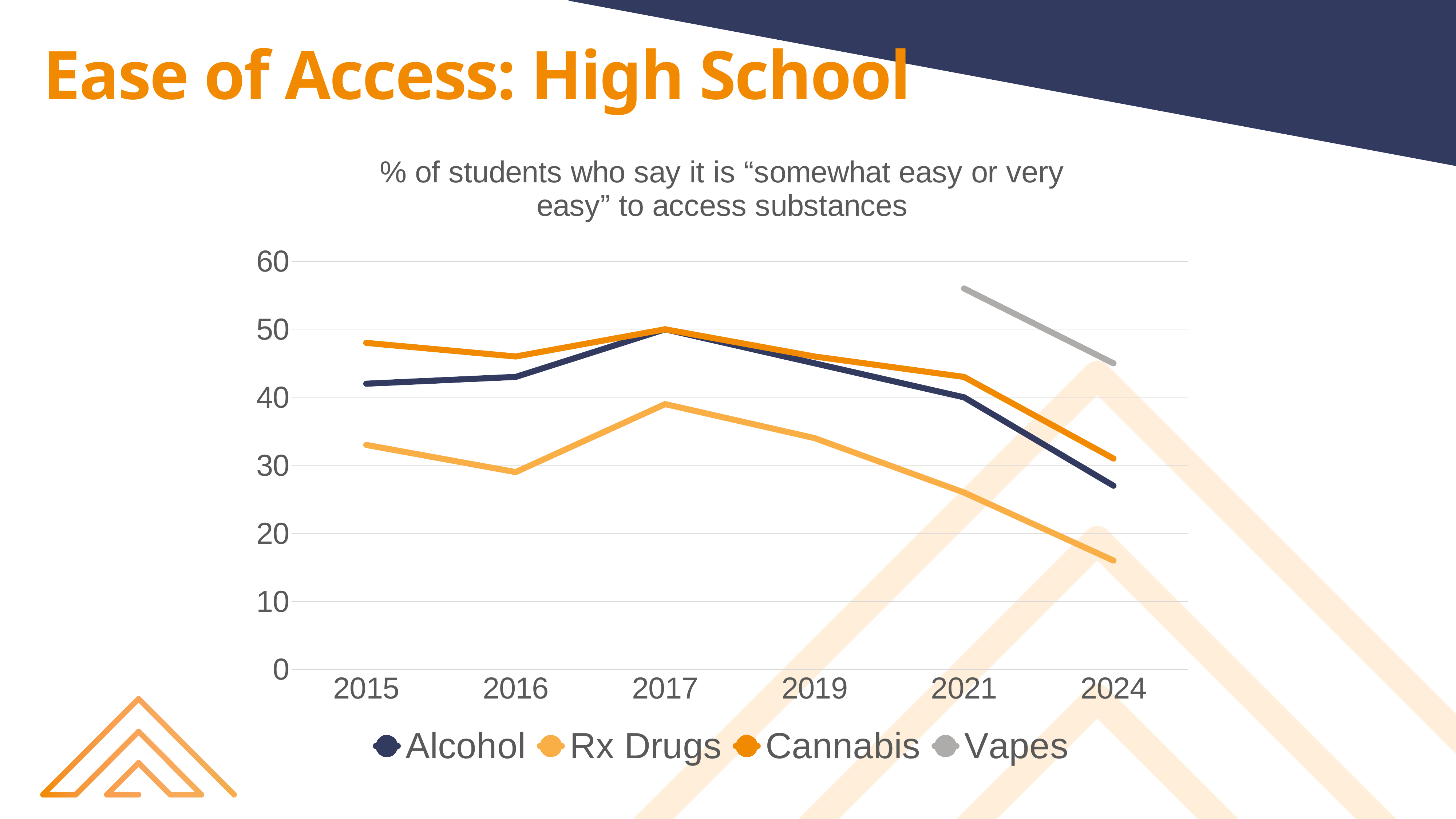
Do the values for Rx Drugs rise or fall from 2017 to 2024? fall How many series does the legend list? 4 Is the value for Vapes in 2021 greater or less than 50? greater Is the value for Cannabis in 2015 greater or less than 40? greater What kind of chart is shown on the slide? line chart Is the value for Alcohol in 2024 greater or less than 30? less In 2015, which is larger: the value for Cannabis or the value for Rx Drugs? Cannabis How many years are shown on the x axis? 6 Which series has the lowest value in 2024? Rx Drugs Which series has the highest value in 2021? Vapes Which series in the legend is shown in grey? Vapes